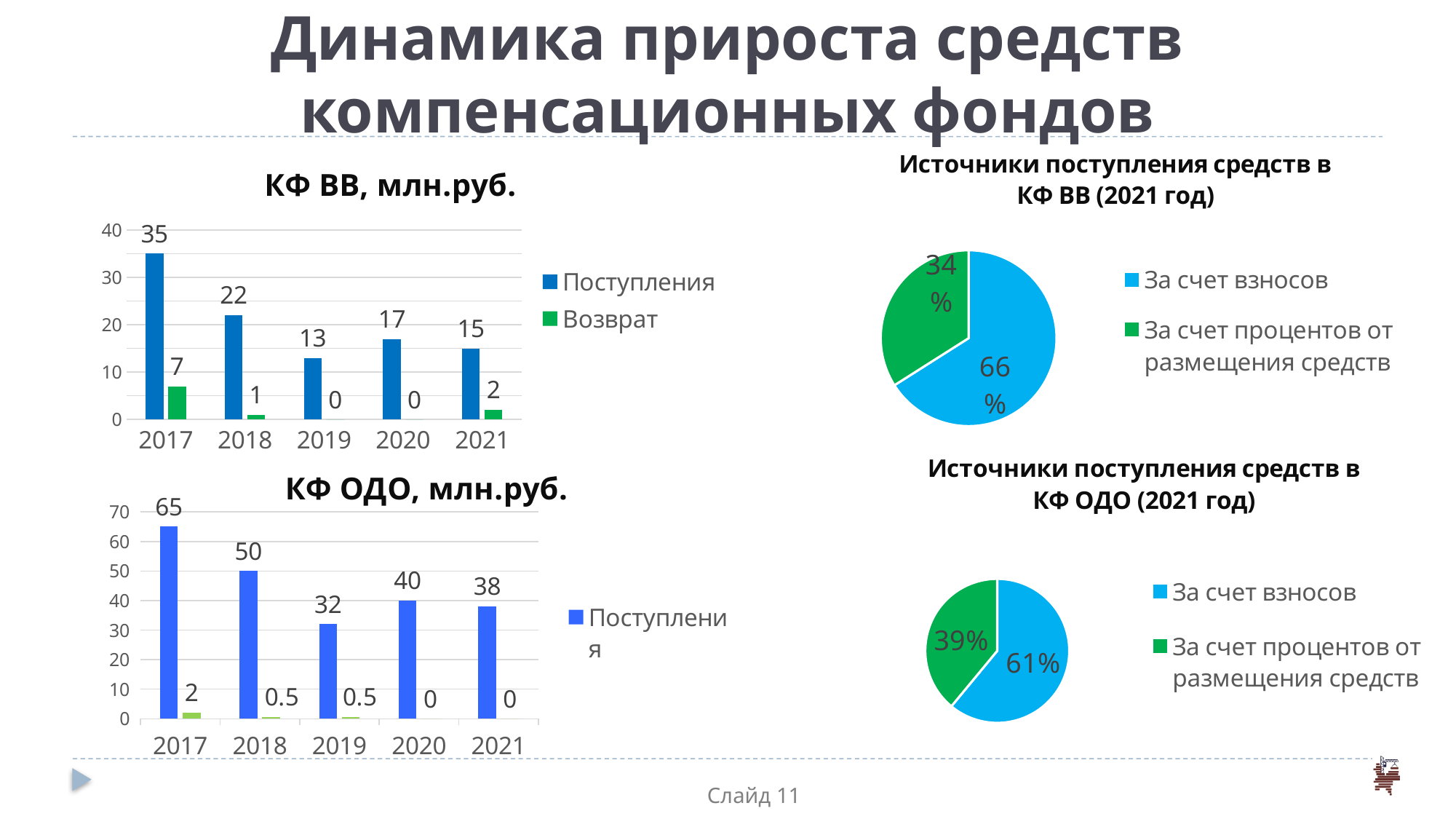
In the chart titled "КФ ВВ, млн.руб.", which year has the lowest Поступления value? 2019 In the chart titled "КФ ВВ, млн.руб.", how many series does the legend list? 2 In the pie chart "Источники поступления средств в КФ ОДО (2021 год)", what share is За счет процентов от размещения средств? 39% In the chart titled "КФ ОДО, млн.руб.", what is the value of Поступления for 2019? 32 In the chart titled "КФ ОДО, млн.руб.", how many years are shown on the x axis? 5 What kind of chart is "КФ ОДО, млн.руб."? Bar chart In the chart titled "КФ ВВ, млн.руб.", what is the value of Поступления for 2017? 35 In the chart titled "КФ ОДО, млн.руб.", is Поступления larger in 2020 or in 2021? 2020 In the chart titled "КФ ВВ, млн.руб.", what is the difference between Поступления in 2017 and 2018? 13 In the chart titled "КФ ВВ, млн.руб.", what is the value of Возврат for 2021? 2 In the chart titled "КФ ОДО, млн.руб.", which year has the highest Поступления value? 2017 In the pie chart "Источники поступления средств в КФ ВВ (2021 год)", what share is За счет взносов? 66%